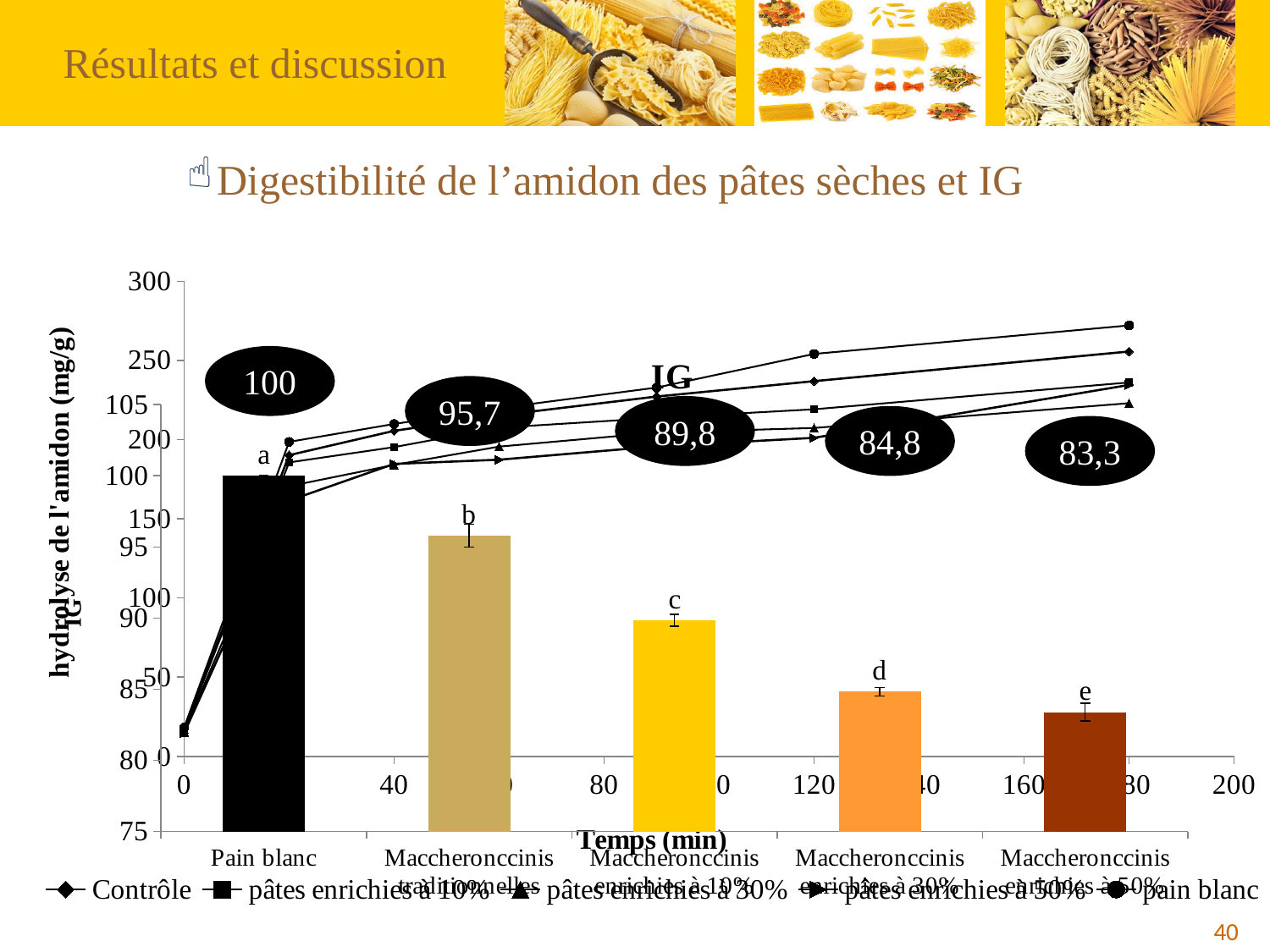
On the IG bar chart, what is the IG value for Maccheronccinis enrichies à 30%? 84,8 On the IG bar chart, which category has the lowest IG? Maccheronccinis enrichies à 50% On the starch hydrolysis line chart, do the values for pain blanc rise or fall as time increases? rise What kind of chart shows the hydrolyse de l'amidon over Temps (min)? line chart On the IG bar chart, what is the IG value for Maccheronccinis traditionnelles? 95,7 How many series does the legend of the starch hydrolysis line chart list? 5 On the IG bar chart, which has a higher IG: Maccheronccinis enrichies à 10% or Maccheronccinis enrichies à 30%? Maccheronccinis enrichies à 10% On the IG bar chart, which category has the highest IG? Pain blanc On the starch hydrolysis line chart, is the value for pain blanc at 180 min greater or less than 250? greater How many bars are shown on the IG bar chart? 5 On the IG bar chart, what is the IG value for Pain blanc? 100 On the IG bar chart, what is the difference in IG between Pain blanc and Maccheronccinis enrichies à 50%? 16,7